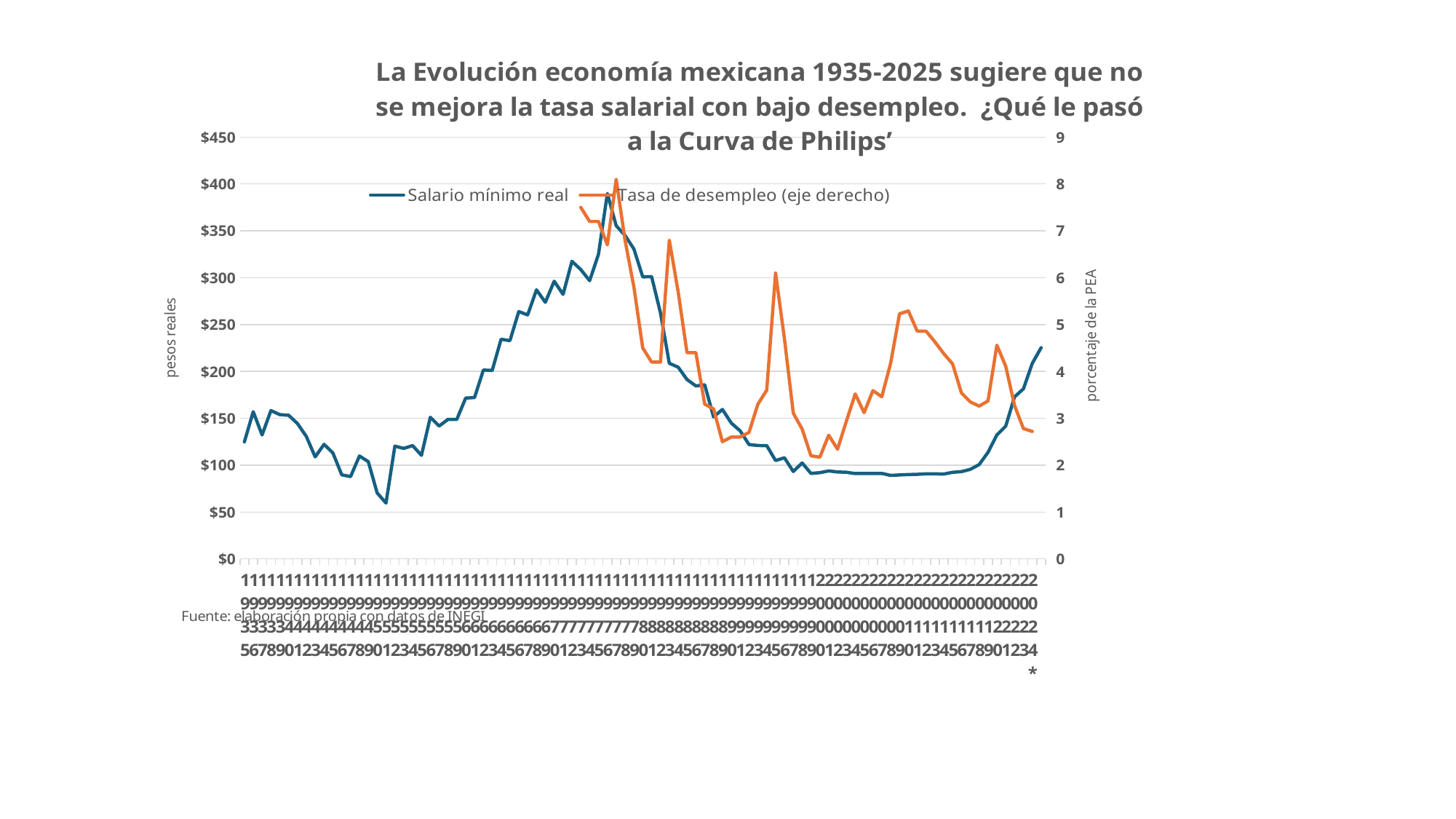
What is the label of the left vertical axis? pesos reales Does the Tasa de desempleo line rise or fall over the last few years of the series? fall What kind of chart is shown on the slide? line chart Is the final point of the Salario mínimo real line greater or less than $200? greater Is the highest point of the Tasa de desempleo line greater or less than 7 on the right axis? greater Which series is plotted against the right-hand axis? Tasa de desempleo (eje derecho) Is the final point of the Tasa de desempleo line greater or less than 3 on the right axis? less Does the Salario mínimo real line rise or fall over the last few years of the series? rise Does the Salario mínimo real line rise or fall from its peak through the following two decades? fall How many series does the legend list? 2